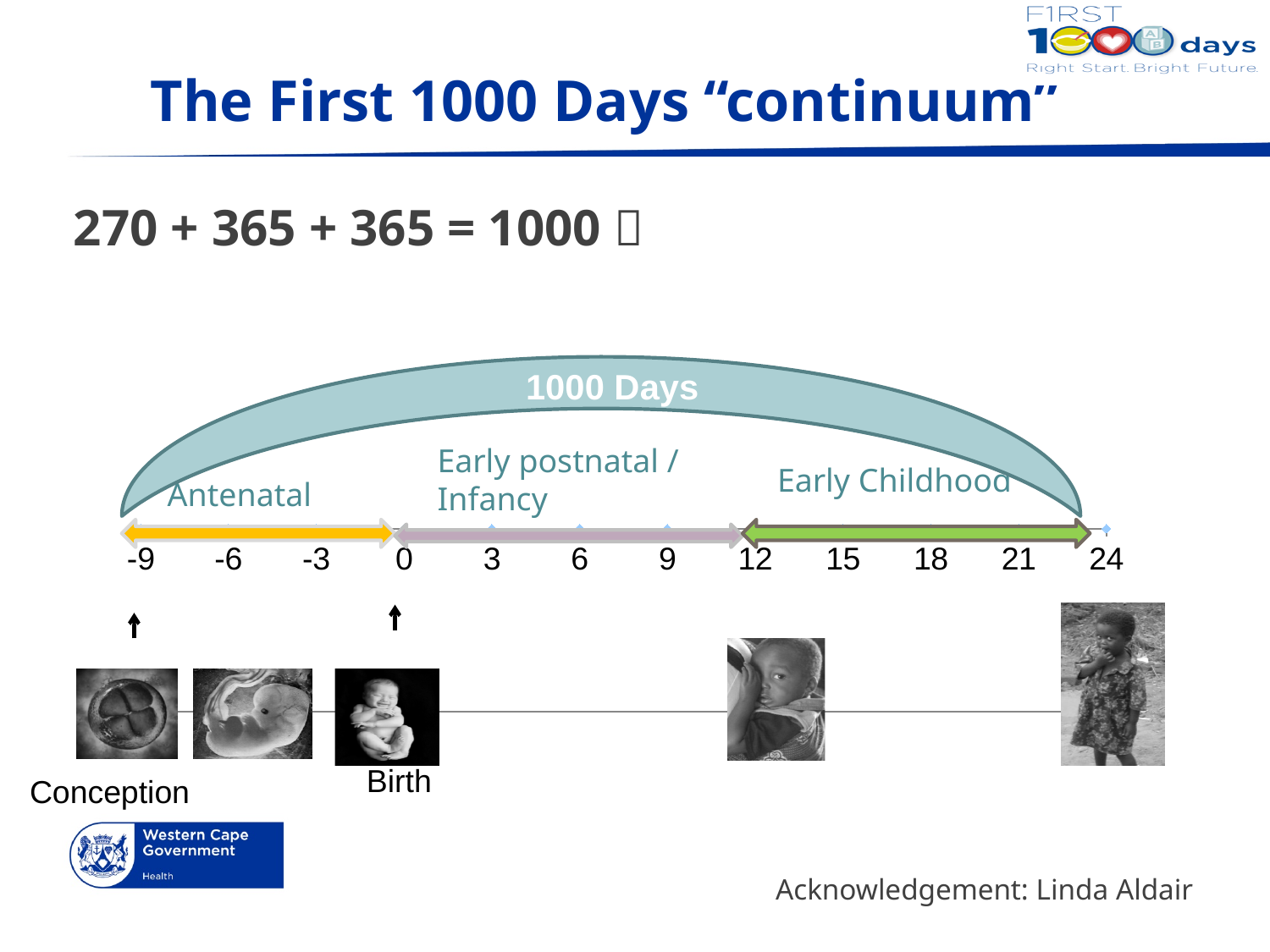
What is the label of the phase covering the green arrow on the timeline? Early Childhood At which axis value does the Early Childhood phase begin on the timeline? 12 What is the label of the phase covering the yellow arrow on the timeline? Antenatal At which axis value is Conception marked on the timeline? -9 What label is written on the arc spanning the timeline? 1000 Days At which axis value is Birth marked on the timeline? 0 What is the highest value shown on the timeline axis? 24 How many tick labels are shown on the timeline axis? 12 How many phases are labelled along the timeline? 3 What is the lowest value shown on the timeline axis? -9